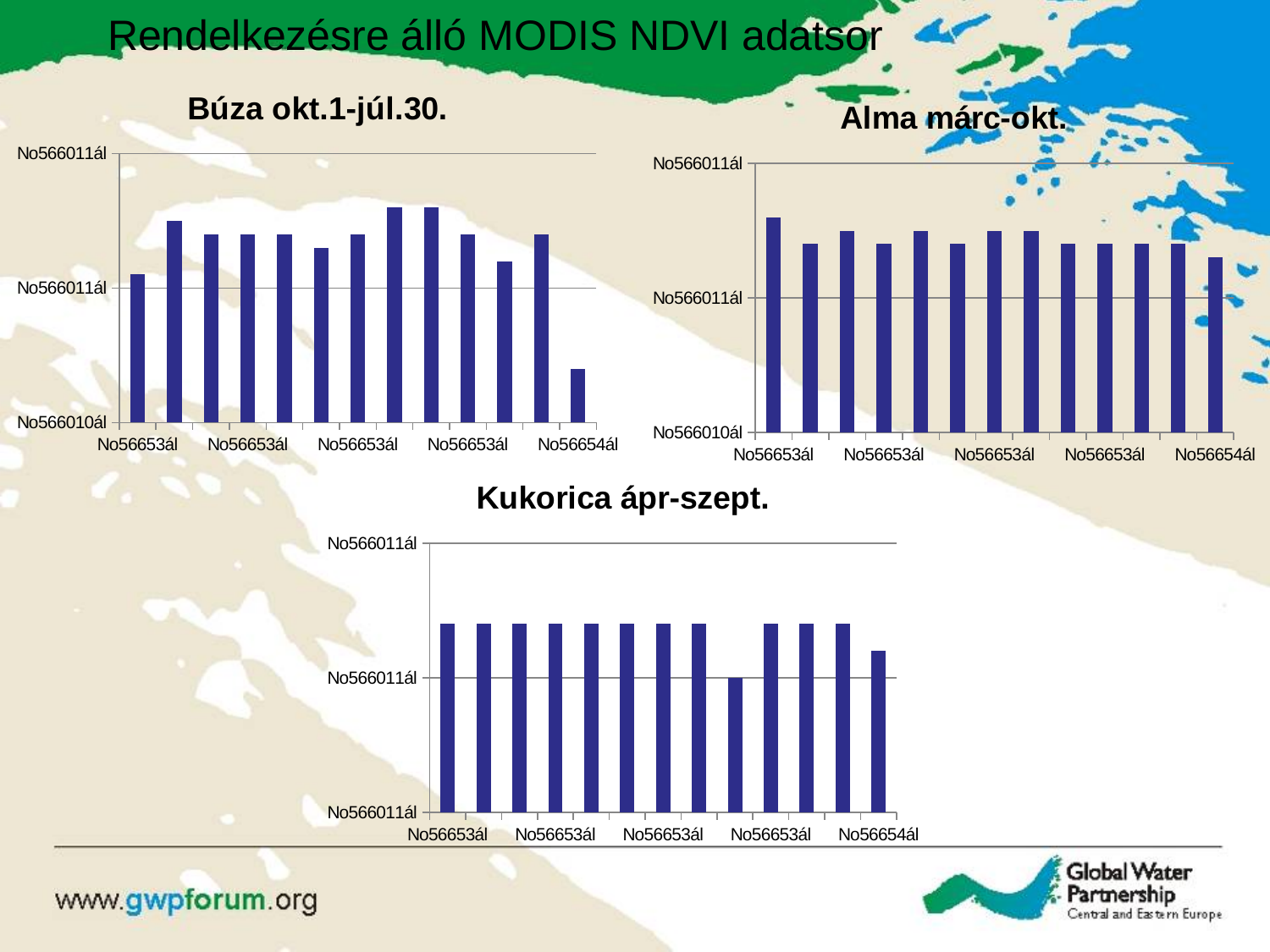
How many bars are plotted in the 'Búza okt.1-júl.30.' chart? 13 In the 'Búza okt.1-júl.30.' chart, is the rightmost bar the shortest bar? yes How many bars are plotted in the 'Alma márc-okt.' chart? 13 In the 'Kukorica ápr-szept.' chart, is the tenth bar from the left the shortest bar? no What is the title of the chart in the top-left of the slide? Búza okt.1-júl.30. How many bars are plotted in the 'Kukorica ápr-szept.' chart? 13 In the 'Alma márc-okt.' chart, is the leftmost bar taller or shorter than the rightmost bar? taller What kind of chart is the 'Búza okt.1-júl.30.' chart? bar chart How many charts are shown on the slide? 3 In the 'Búza okt.1-júl.30.' chart, is the rightmost bar taller or shorter than the leftmost bar? shorter What kind of chart is the 'Kukorica ápr-szept.' chart? bar chart